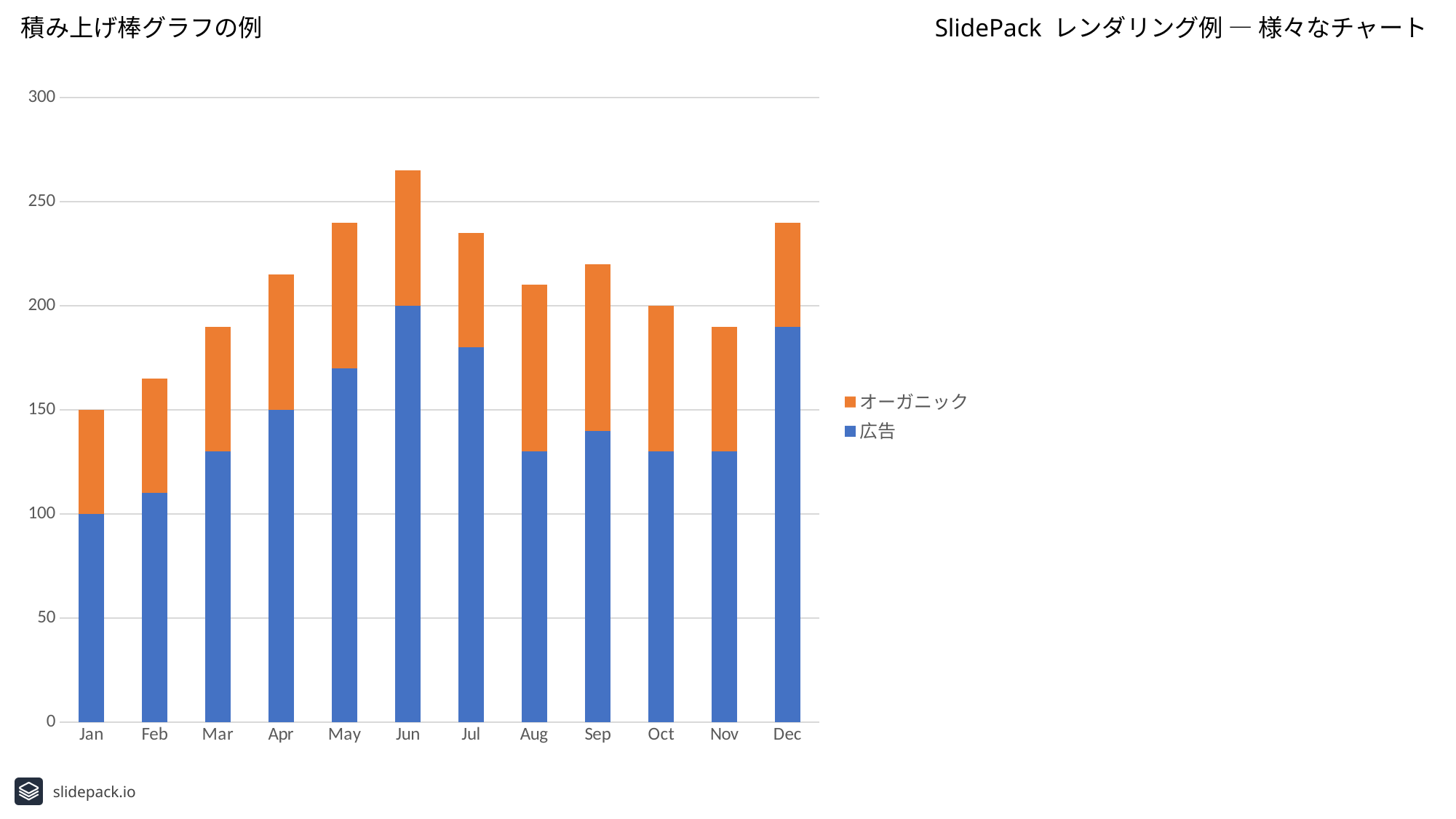
Is the total value for Dec greater or less than 200? greater Which month has the highest total stacked bar? Jun What is the total of the stacked bar for Jan? 150 What is the total of the stacked bar for Oct? 200 What is the value of 広告 for Jan? 100 What is the value of 広告 for Jun? 200 How many series does the chart's legend list? 2 Which colour represents オーガニック in the chart? Orange How many months are shown on the x axis of the chart? 12 What kind of chart is shown on the slide? Stacked bar chart Which month has the lowest total stacked bar? Jan Which month has the larger 広告 value, Dec or Jan? Dec